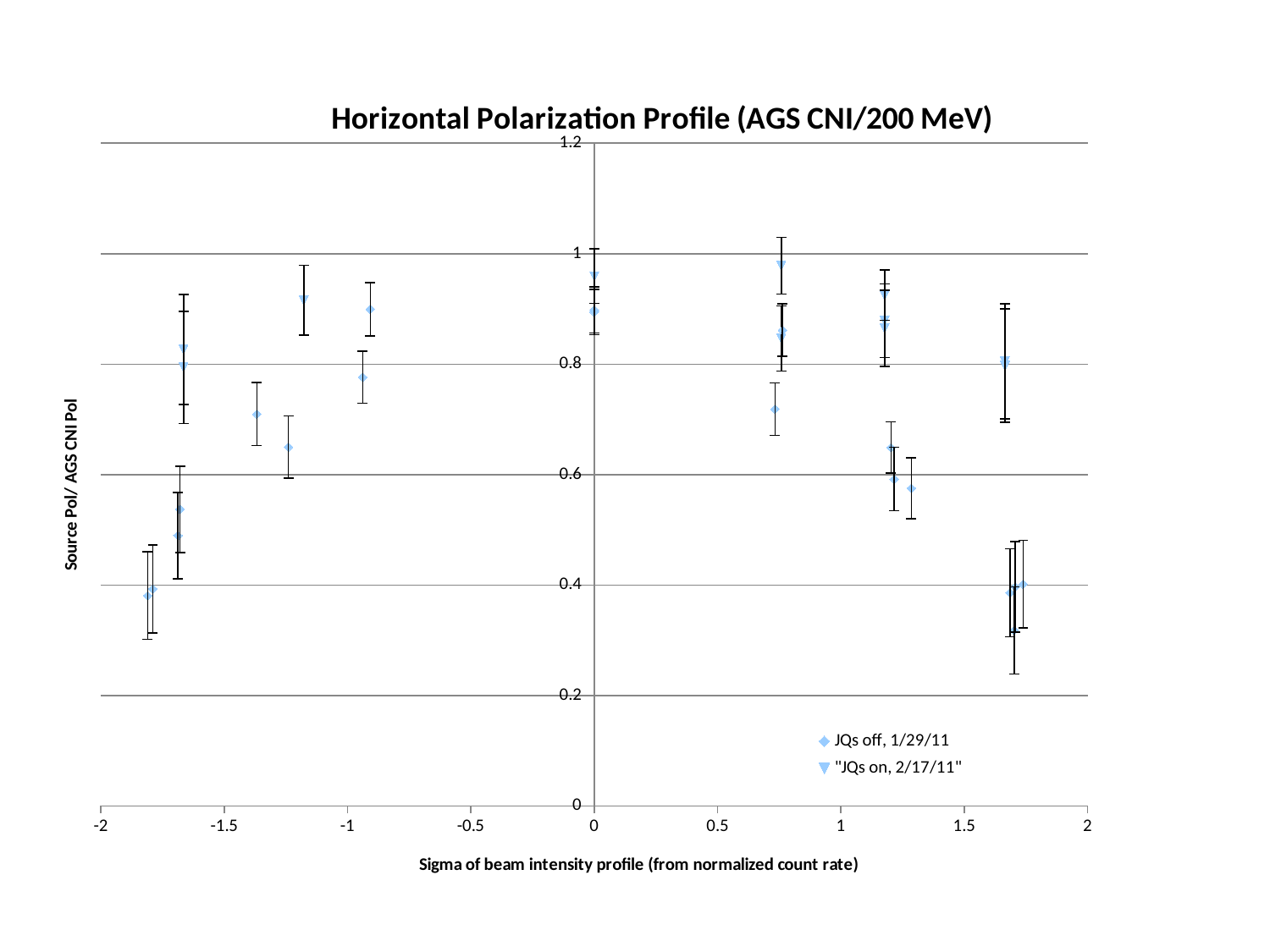
Is the value of the "JQs on, 2/17/11" point near x = -1.2 greater or less than 0.8? greater Are the "JQs off, 1/29/11" values near x = 1.7 greater or less than 0.6? less Is the value of the "JQs off, 1/29/11" point near x = 1.3 greater or less than 0.8? less Do the plotted values generally rise or fall as x goes from 0 to 2? fall What kind of chart is shown on the slide? scatter chart How many series does the legend list? 2 What is the title of the chart? Horizontal Polarization Profile (AGS CNI/200 MeV) What is the label of the x axis? Sigma of beam intensity profile (from normalized count rate) Do the plotted values generally rise or fall as x goes from -2 to 0? rise